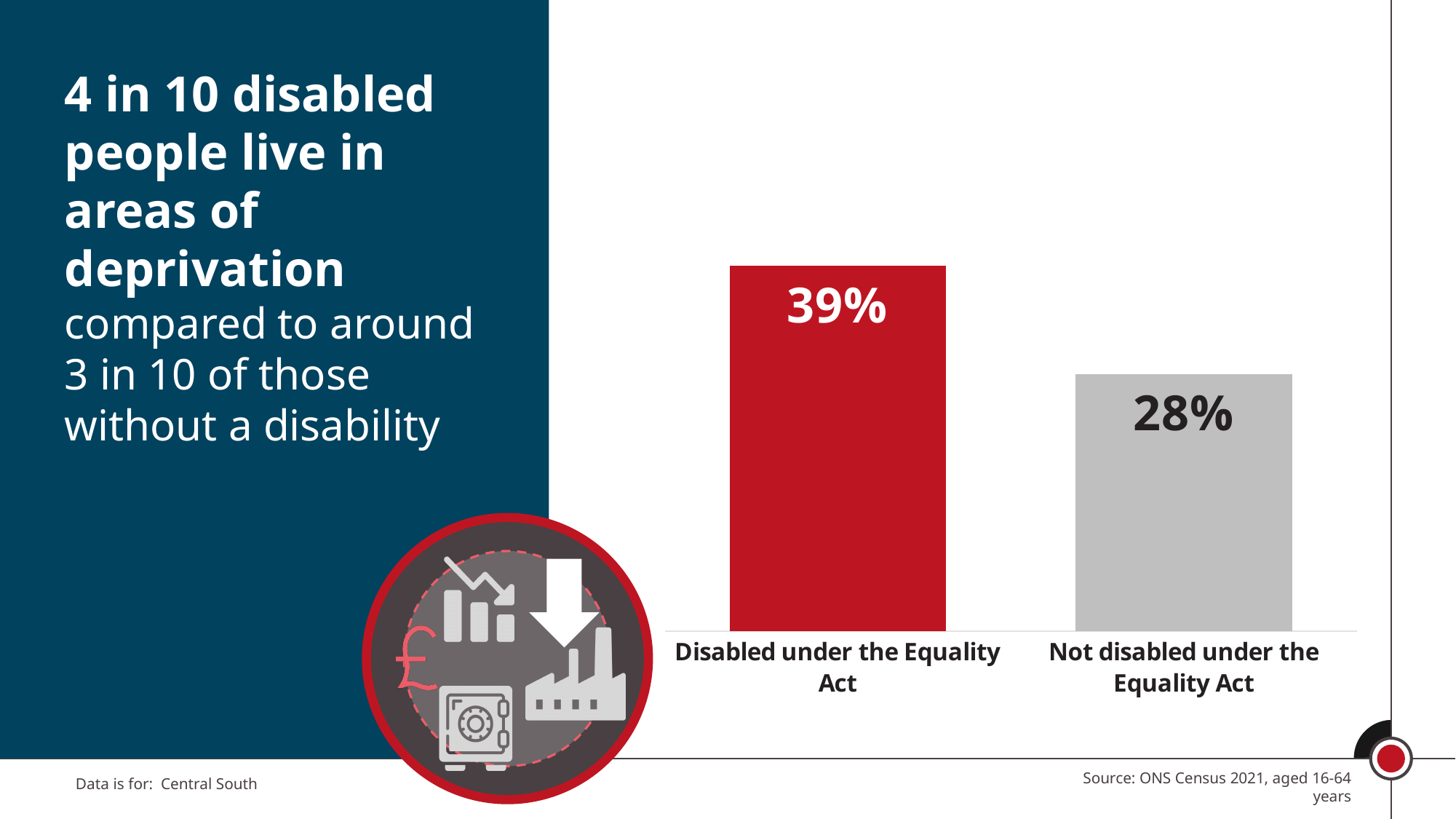
What kind of chart is shown on the slide? Bar chart What is the difference between the values for Disabled under the Equality Act and Not disabled under the Equality Act? 11 percentage points Which category has the highest value? Disabled under the Equality Act What colour is the bar for Not disabled under the Equality Act? Grey Which is larger, the value for Disabled under the Equality Act or Not disabled under the Equality Act? Disabled under the Equality Act What is the value for Disabled under the Equality Act? 39% Which category has the lowest value? Not disabled under the Equality Act What colour is the bar for Disabled under the Equality Act? Red What is the value for Not disabled under the Equality Act? 28% How many categories are shown in the chart? 2